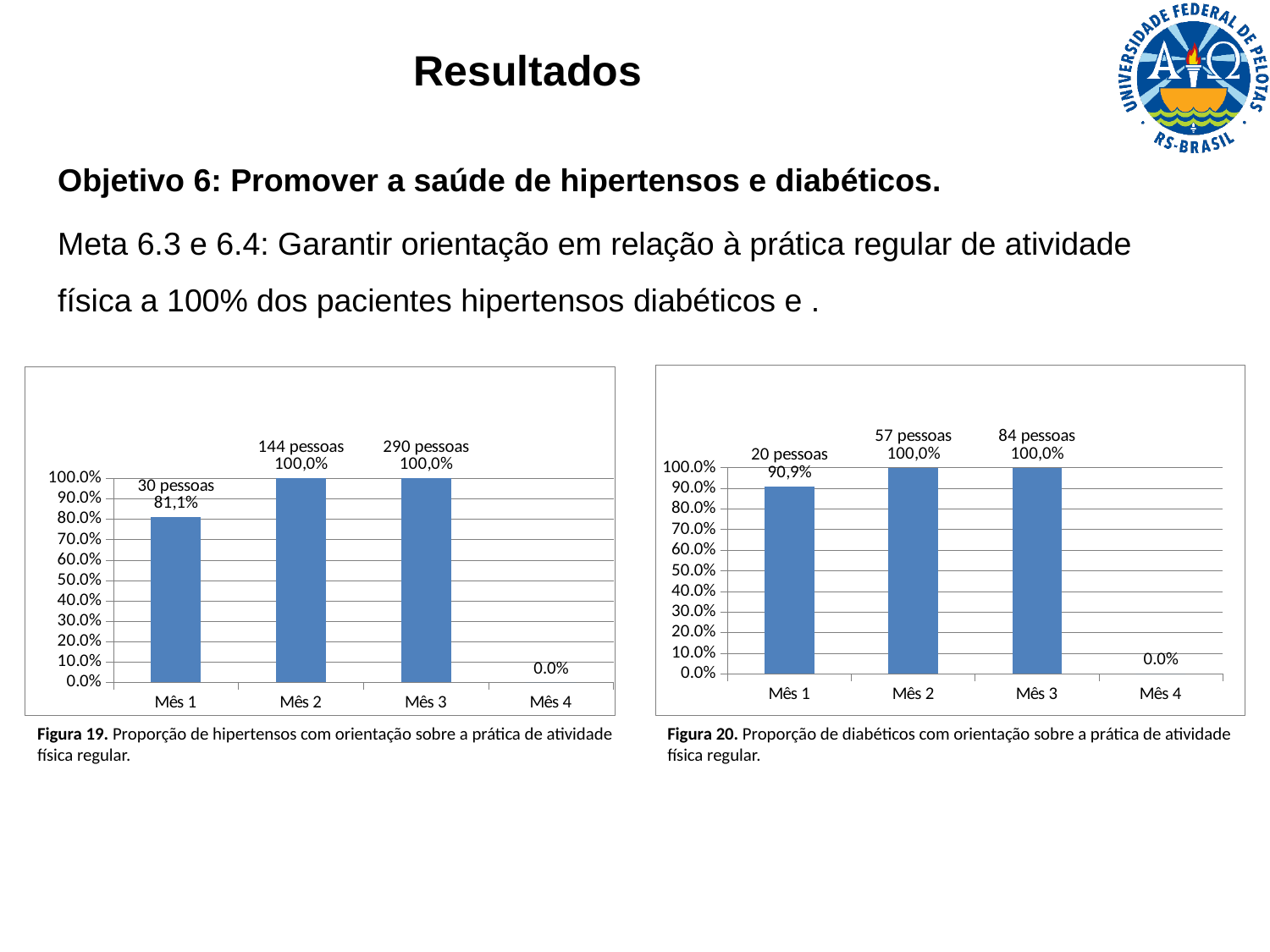
In the right chart (Figura 20, diabéticos), what is the difference in percentage points between Mês 2 and Mês 1? 9,1 In the right chart (Figura 20, diabéticos), what is the percentage shown for Mês 1? 90,9% In the left chart (Figura 19, hipertensos), which month has the lowest percentage? Mês 4 In the left chart (Figura 19, hipertensos), is the value for Mês 1 greater or less than 70.0%? greater How many charts are shown on the slide? 2 In the left chart (Figura 19, hipertensos), how many people does the label for Mês 3 report? 290 pessoas What type of chart is Figura 19 (the left chart)? Bar chart How many months (categories) are shown on the x axis of the right chart (Figura 20)? 4 In the right chart (Figura 20, diabéticos), how many people does the label for Mês 2 report? 57 pessoas In the right chart (Figura 20, diabéticos), what is the percentage shown for Mês 4? 0.0% In the left chart (Figura 19, hipertensos), what is the percentage shown for Mês 1? 81,1% In the left chart (Figura 19, hipertensos), is the percentage for Mês 2 larger or smaller than that for Mês 1? larger